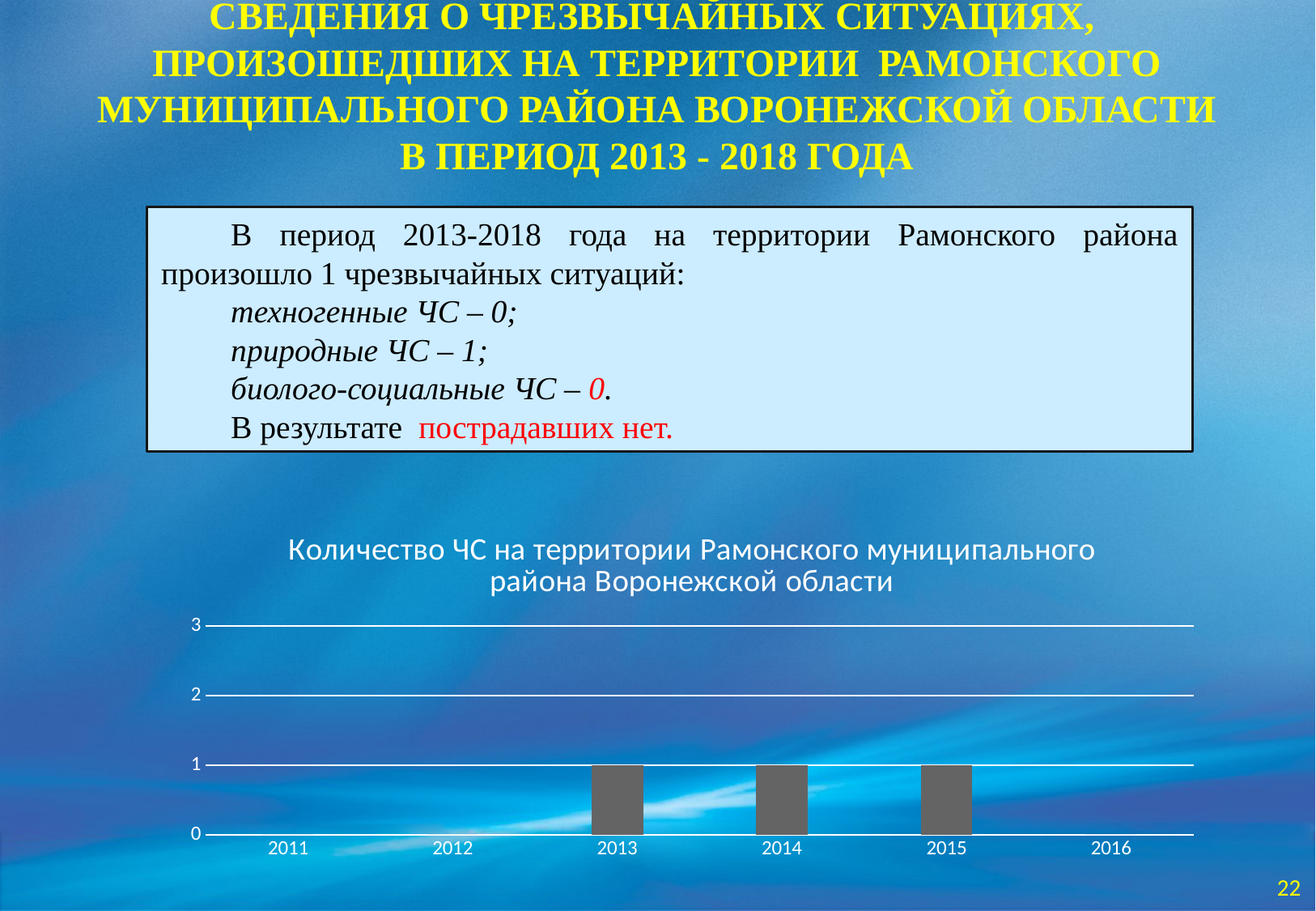
What is the value for 2014 in the chart? 1 What is the title of the chart? Количество ЧС на территории Рамонского муниципального района Воронежской области What is the value for 2015 in the chart? 1 What is the value for 2013 in the chart? 1 Which is larger, the value for 2013 or the value for 2012? 2013 What is the difference between the value for 2015 and the value for 2016? 1 How many year categories are shown on the x axis of the chart? 6 What type of chart is shown on the slide? bar chart What is the highest value shown on the y axis of the chart? 3 What is the value for 2011 in the chart? 0 What is the value for 2016 in the chart? 0 Is the value for 2014 greater or less than 2? less